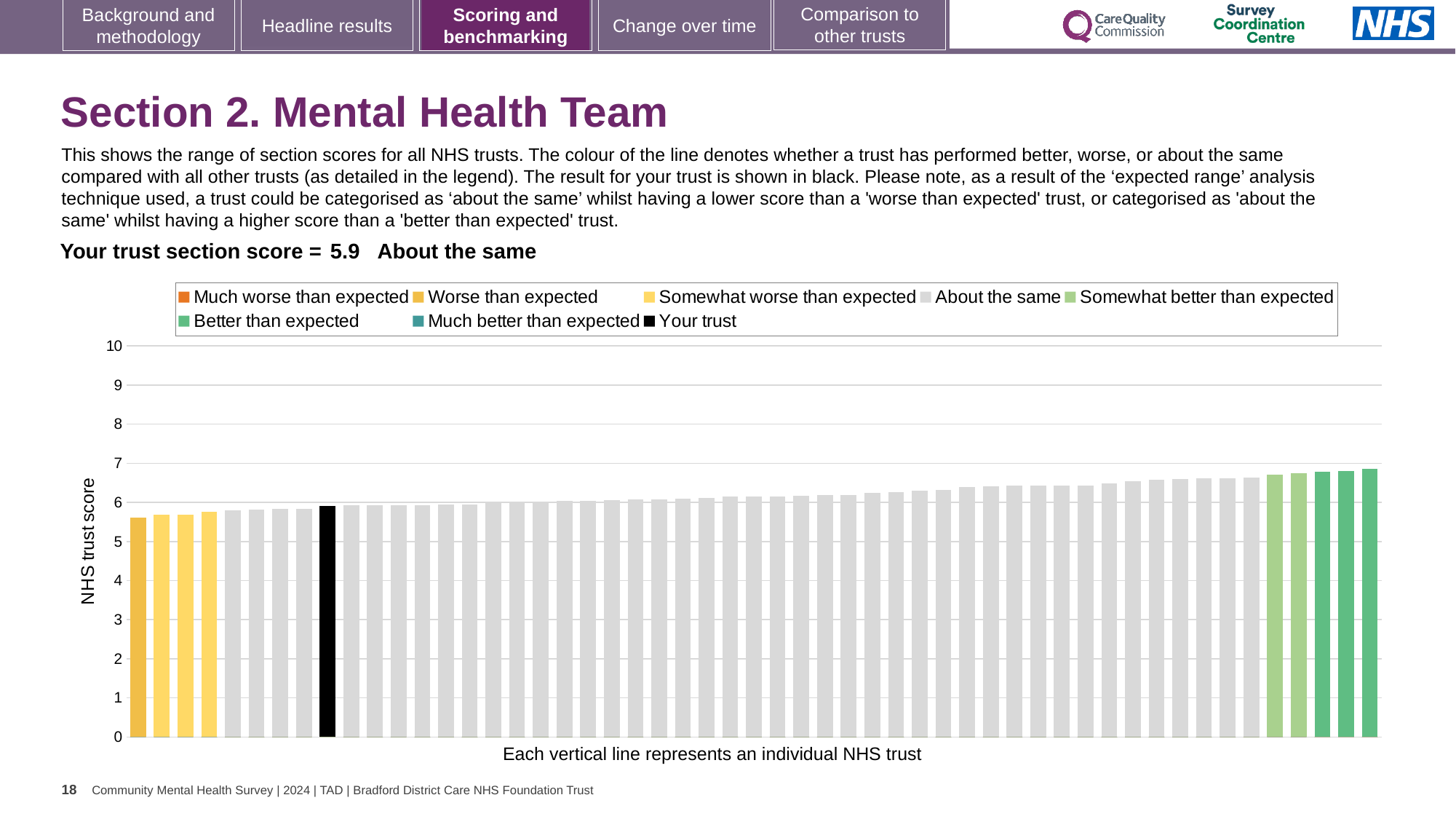
Is the value of the lowest bar in the chart greater or less than 5? greater What is the maximum value shown on the vertical axis? 10 What type of chart is shown on the slide? bar chart Is the value for your trust (the black bar) greater or less than 5? greater What is the section score for your trust shown on the slide? 5.9 Is the value of the lowest bar in the chart greater or less than 6? less What is the label on the vertical axis of the chart? NHS trust score Do the bar values rise or fall from left to right along the x axis? rise How many categories does the chart legend list? 8 What colour is used for the bar representing your trust? black Which performance category is your trust placed in for this section? About the same